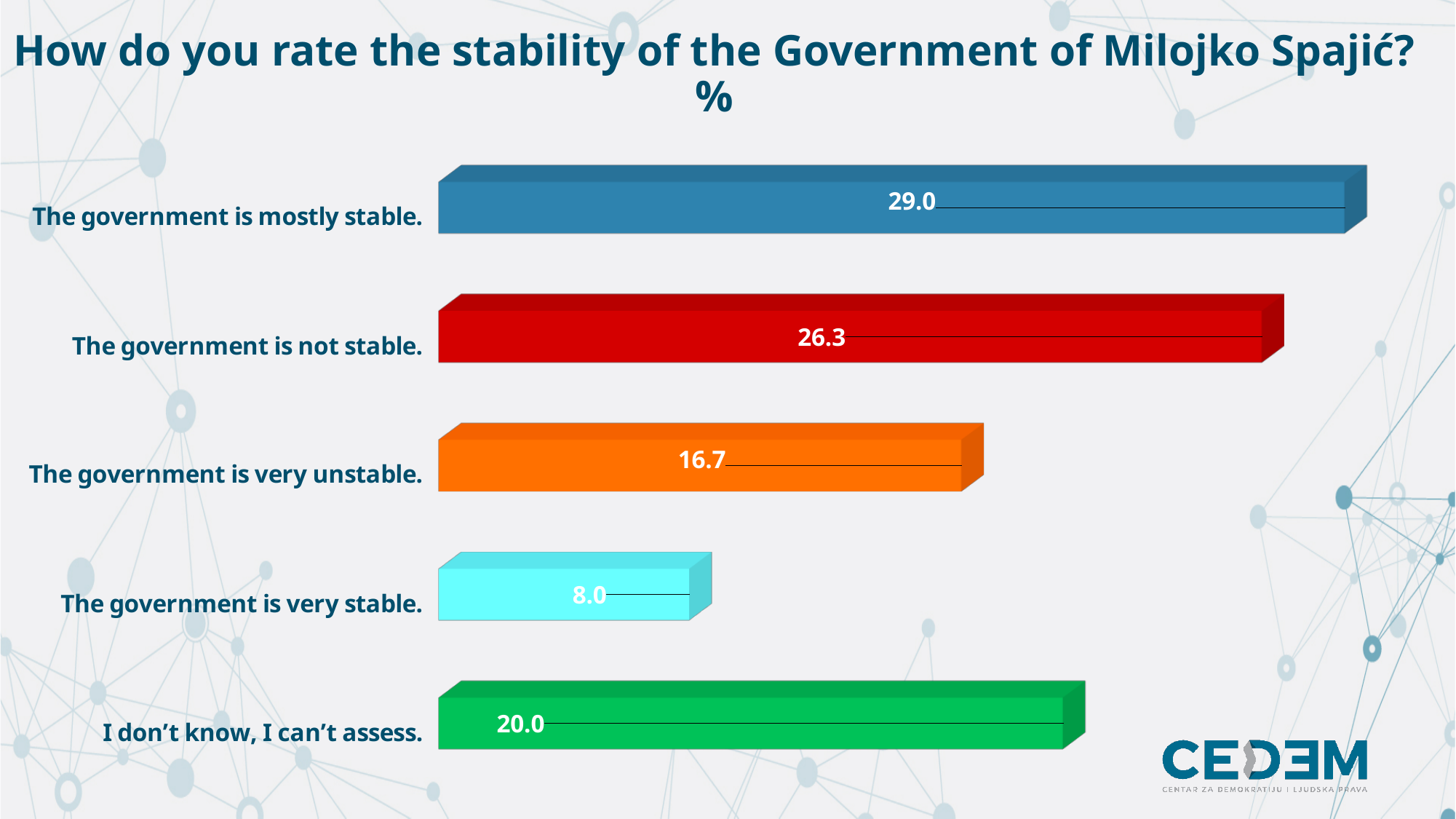
Which is larger: the value for "The government is very unstable." or "I don't know, I can't assess."? I don't know, I can't assess. Which category has the highest value? The government is mostly stable. What is the value for "The government is very unstable."? 16.7 What kind of chart is shown on the slide? Bar chart What colour is the bar for "The government is not stable."? Red What is the difference between the values for "The government is mostly stable." and "The government is not stable."? 2.7 What is the value for "The government is mostly stable."? 29.0 How many categories are shown in the chart? 5 What is the value for "The government is very stable."? 8.0 Which category has the lowest value? The government is very stable. What is the value for "I don't know, I can't assess."? 20.0 What is the value for "The government is not stable."? 26.3